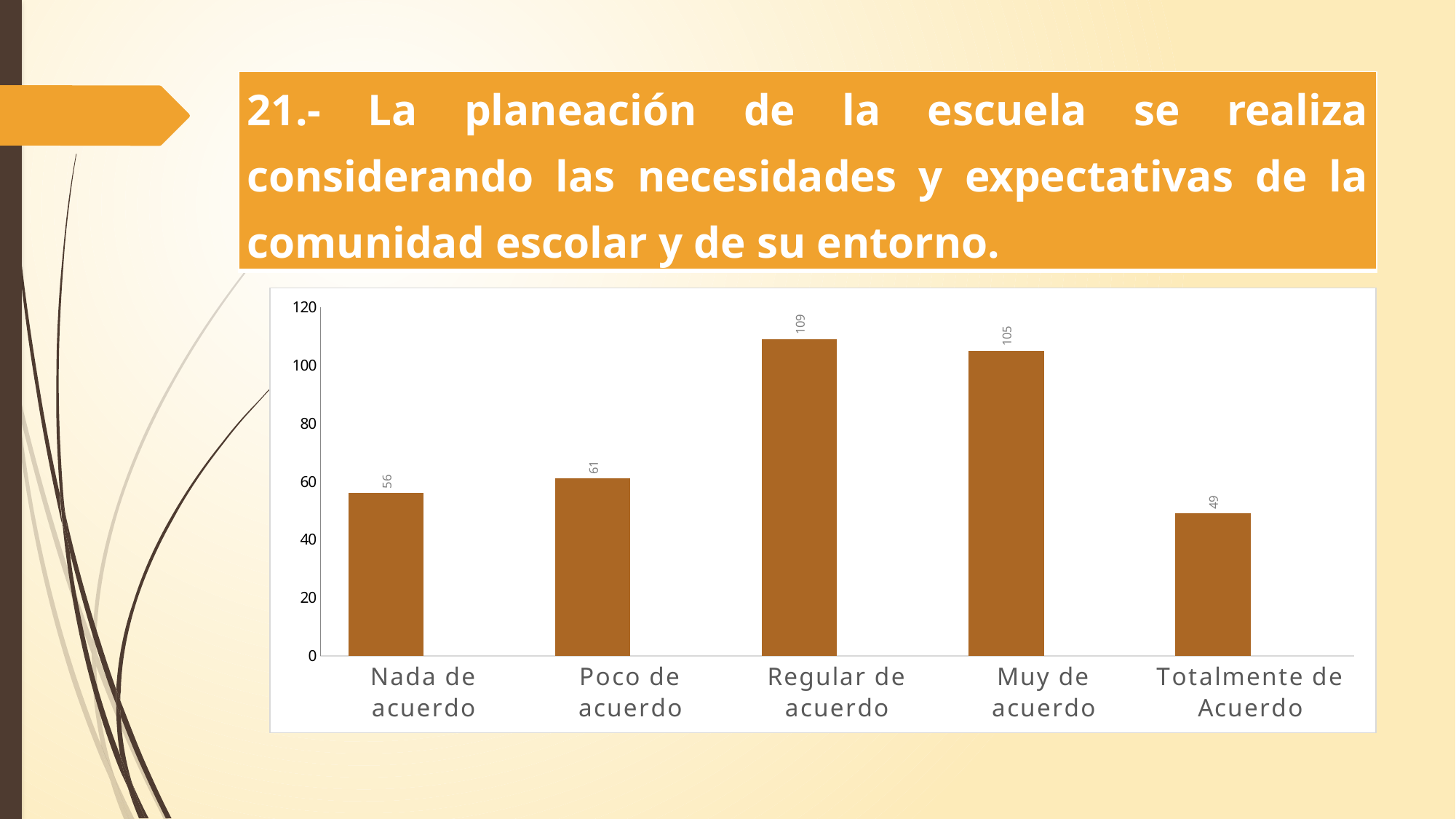
What is the value for "Totalmente de Acuerdo"? 49 Is the value for "Muy de acuerdo" greater or less than 100? greater How many categories are shown on the x axis? 5 What is the difference between the values for "Regular de acuerdo" and "Muy de acuerdo"? 4 What is the highest value shown on the vertical axis? 120 Which is larger, the value for "Poco de acuerdo" or the value for "Totalmente de Acuerdo"? Poco de acuerdo What kind of chart is shown on the slide? bar chart What is the difference between the values for "Poco de acuerdo" and "Nada de acuerdo"? 5 What is the value for "Nada de acuerdo"? 56 Which category has the highest value? Regular de acuerdo Which category has the lowest value? Totalmente de Acuerdo What is the value for "Regular de acuerdo"? 109